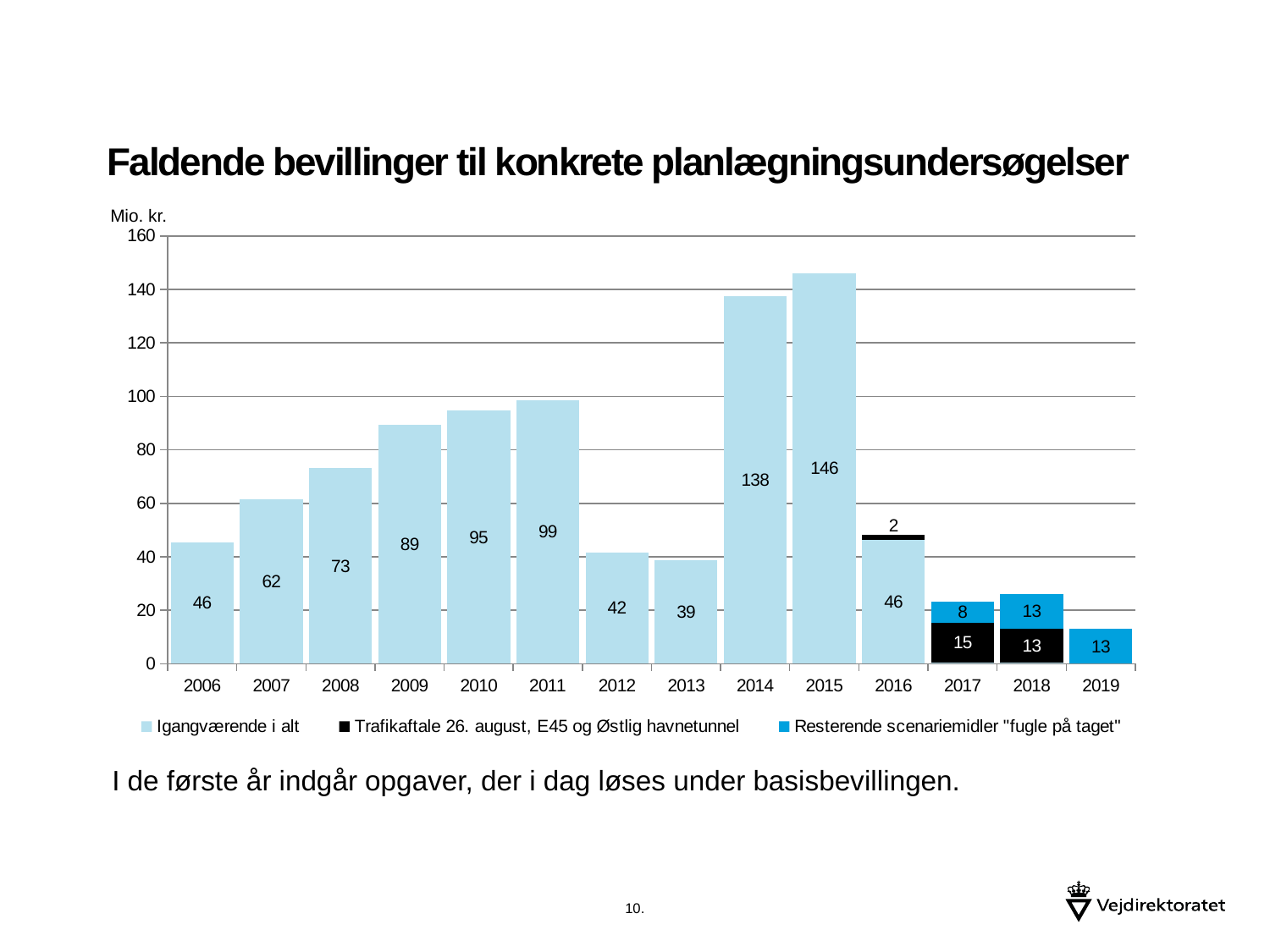
What is the total of the stacked bar for 2017? 23 What is the value for Trafikaftale 26. august, E45 og Østlig havnetunnel in 2017? 15 What is the value for Igangværende i alt in 2015? 146 How many series does the legend list? 3 What is the value for Resterende scenariemidler "fugle på taget" in 2019? 13 Which year has the highest value for Igangværende i alt? 2015 Which is larger, the Igangværende i alt value for 2011 or for 2010? 2011 What is the difference between the Igangværende i alt values for 2015 and 2014? 8 How many years are shown on the x axis? 14 What kind of chart is shown on the slide? Stacked bar chart